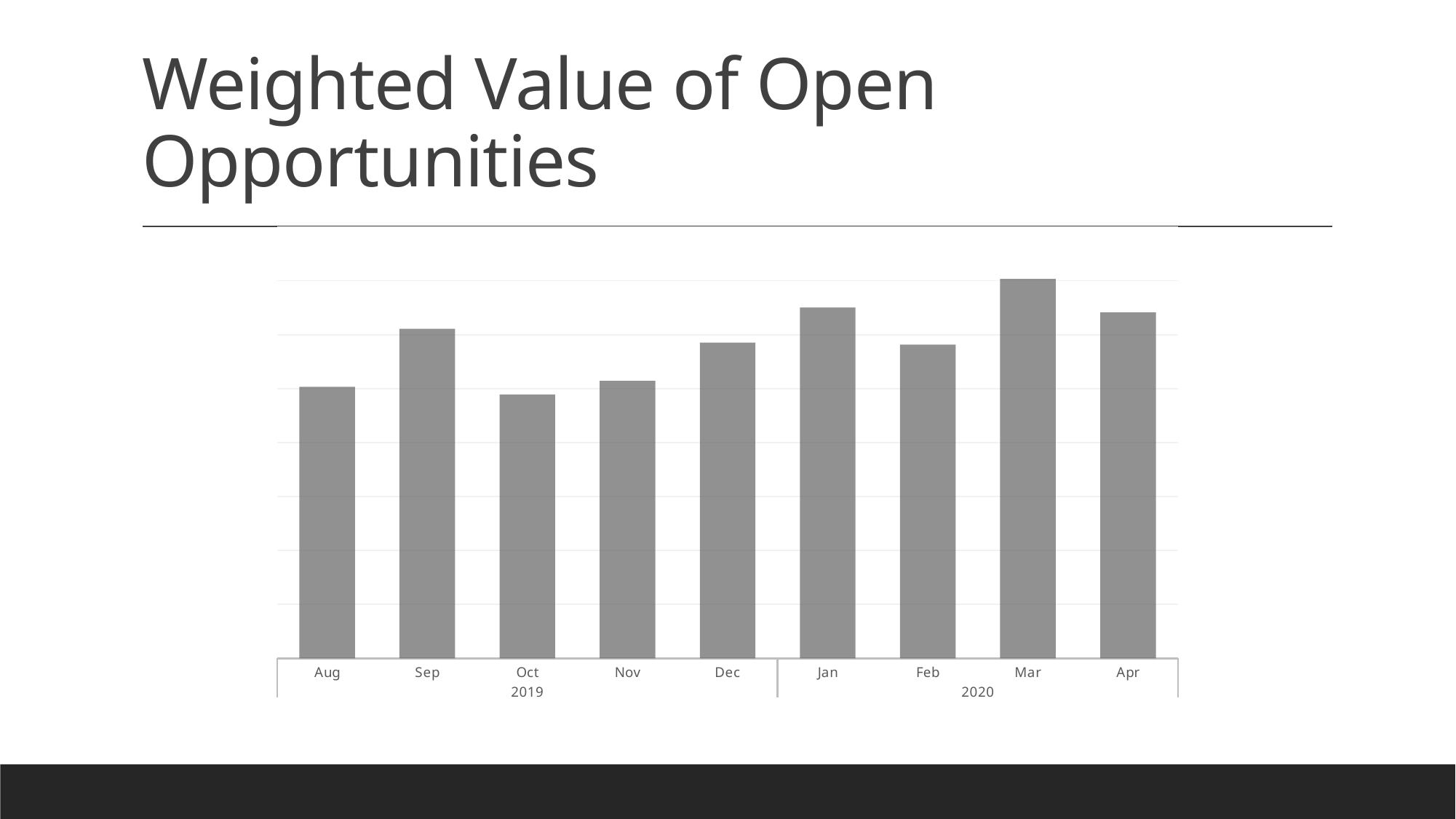
Do the values rise or fall from Mar to Apr? fall How many of the plotted months fall in 2020? 4 What is the title of the slide? Weighted Value of Open Opportunities Which month has the highest weighted value of open opportunities? Mar Which is larger, the value for Dec or the value for Oct? Dec Do the values rise or fall from Oct to Jan? rise How many months (bars) are plotted in the chart? 9 What kind of chart is shown on the slide? bar chart Which is larger, the value for Mar or the value for Apr? Mar Which two years are labelled on the x axis of the chart? 2019 and 2020 Which is larger, the value for Sep or the value for Aug? Sep